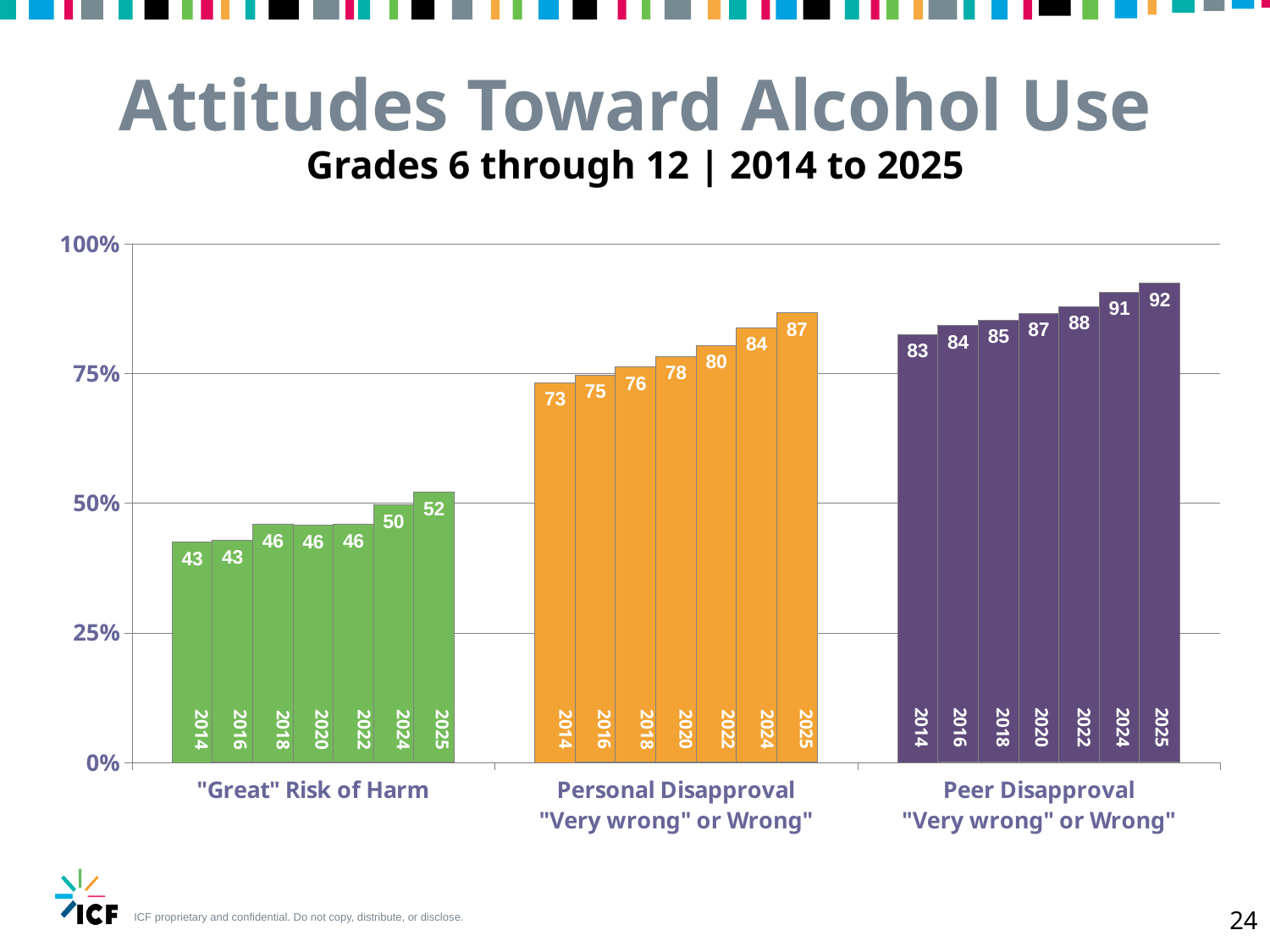
What is the value for Peer Disapproval in 2020? 87 Is the value for "Great" Risk of Harm in 2024 greater or less than 25%? greater Do the Peer Disapproval values rise or fall from 2014 to 2025? Rise Which year has the lowest value for Personal Disapproval? 2014 What kind of chart is shown on the slide? Bar chart What is the value for "Great" Risk of Harm in 2025? 52 How many years are shown for each of the three groups? 7 Which year has the highest value for Peer Disapproval? 2025 Which is larger: Peer Disapproval in 2014 or Personal Disapproval in 2025? Personal Disapproval in 2025 What is the difference between the Personal Disapproval values for 2025 and 2014? 14 What colour are the bars for Personal Disapproval? Orange What is the value for Personal Disapproval in 2014? 73